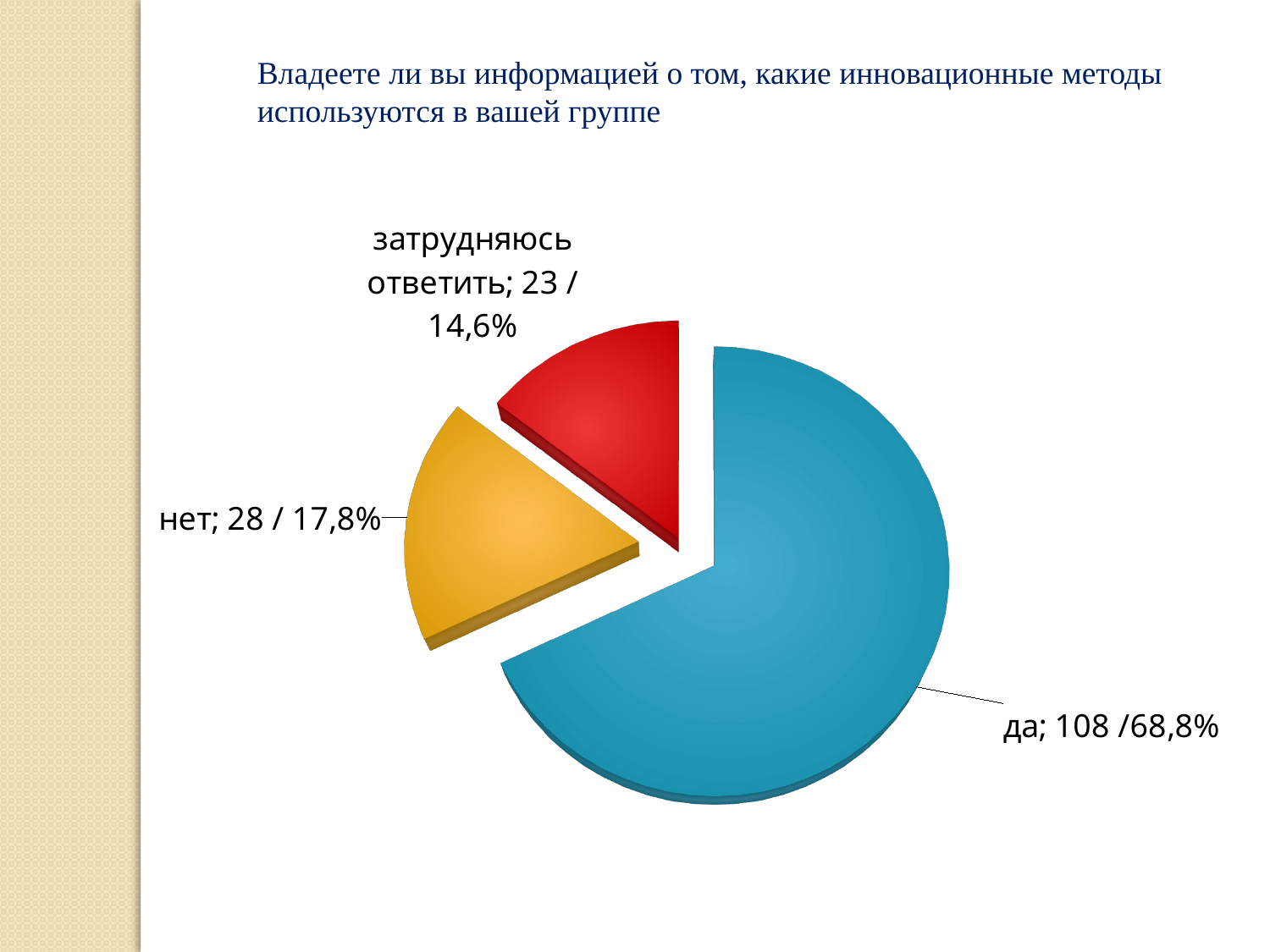
What is the difference in count between "нет" and "затрудняюсь ответить"? 5 What percentage share does the "да" slice have? 68,8% Which category has the largest slice? да What is the count for the "затрудняюсь ответить" slice? 23 What kind of chart is shown on the slide? pie chart What percentage share does the "затрудняюсь ответить" slice have? 14,6% What is the count for the "нет" slice? 28 What percentage share does the "нет" slice have? 17,8% Which category has the smallest slice? затрудняюсь ответить What is the count for the "да" slice? 108 How many slices does the pie chart have? 3 Which colour is the "да" slice? blue